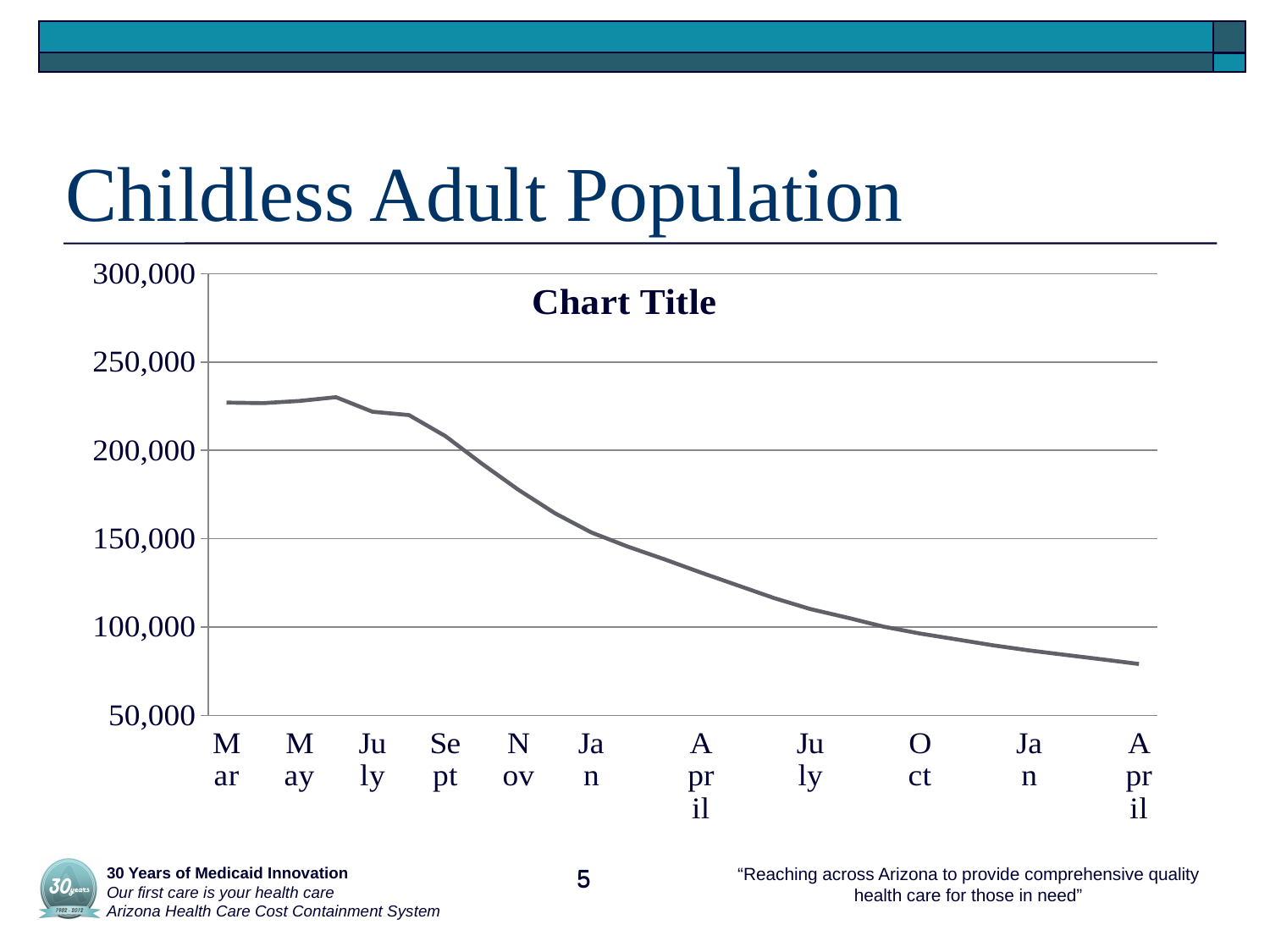
Is the value for Nov greater or less than 150,000? greater Is the value for the first April on the x axis greater or less than 150,000? less Which x-axis label has the lowest value? April (the last label) Which is larger, the value for Sept or the value for the second July? Sept How many labels are shown on the x axis? 11 Is the value for Mar greater or less than 200,000? greater What kind of chart is shown on the slide? line chart Which is larger, the value for Mar or the value for the final April? Mar What is the title printed inside the chart area? Chart Title Do the values rise or fall overall from left to right along the x axis? fall